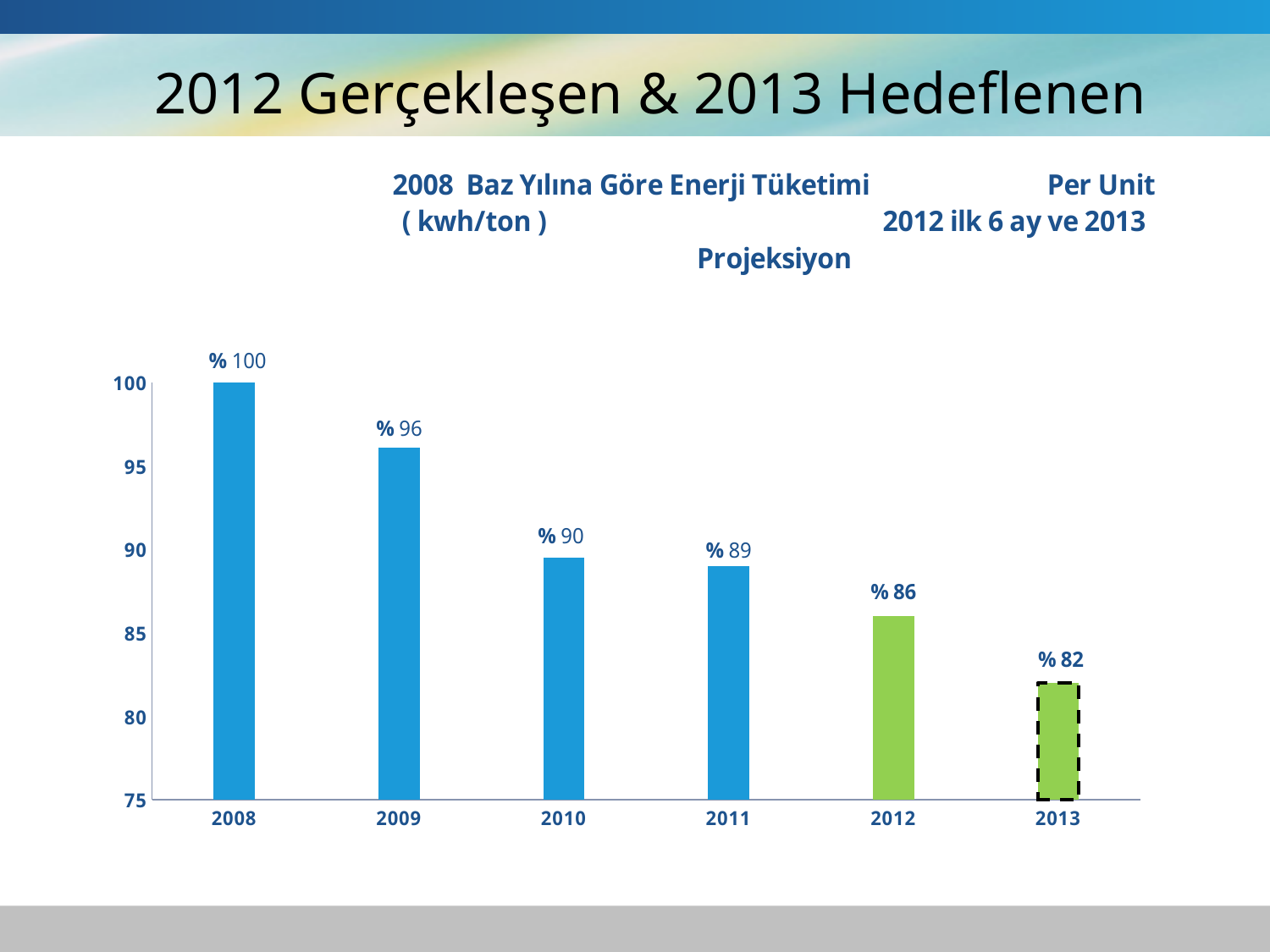
Which is larger, the value for 2009 or the value for 2011? 2009 What is the value shown for 2008? % 100 What kind of chart is shown? bar chart Which year has the lowest value? 2013 What is the difference between the values for 2011 and 2012? 3 What is the value shown for 2013? % 82 How many years are shown on the x axis? 6 Which year has the highest value? 2008 What is the value shown for 2010? % 90 What is the difference between the values for 2008 and 2013? 18 Do the values rise or fall from 2008 to 2013? fall What is the value shown for 2012? % 86